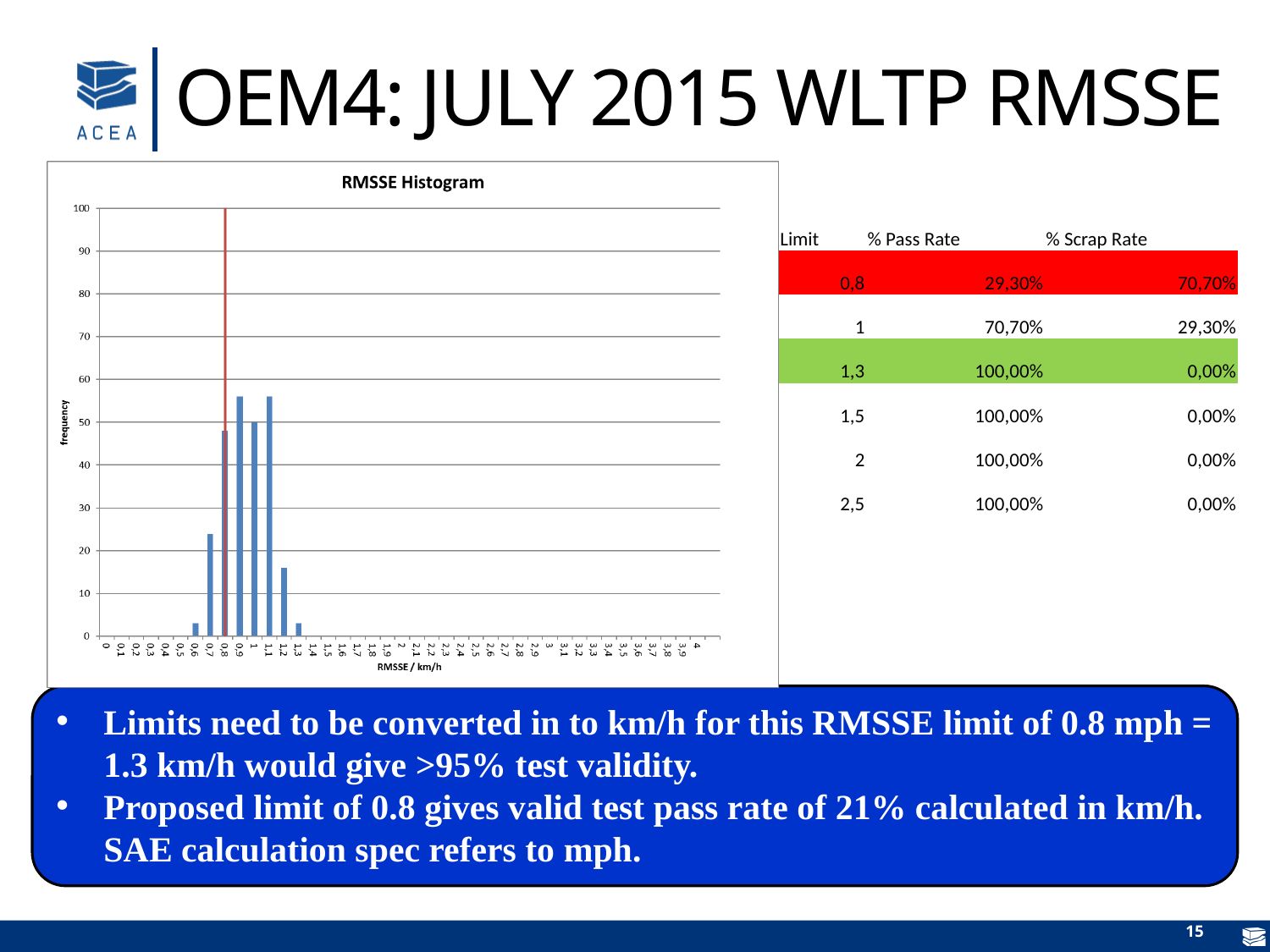
How many RMSSE bins in the RMSSE Histogram have a non-zero frequency? 8 In the RMSSE Histogram, is the frequency for 1,2 greater or less than 20? less In the RMSSE Histogram, is the frequency for 0,8 greater or less than 40? greater What is the title of the chart on the slide? RMSSE Histogram In the RMSSE Histogram, is the frequency for 0,6 greater or less than 10? less In the RMSSE Histogram, which has the higher frequency, 0,7 or 0,8? 0,8 What is the label of the x axis of the RMSSE Histogram? RMSSE / km/h What kind of chart is the RMSSE Histogram? bar chart In the RMSSE Histogram, which has the higher frequency, 0,9 or 1,2? 0,9